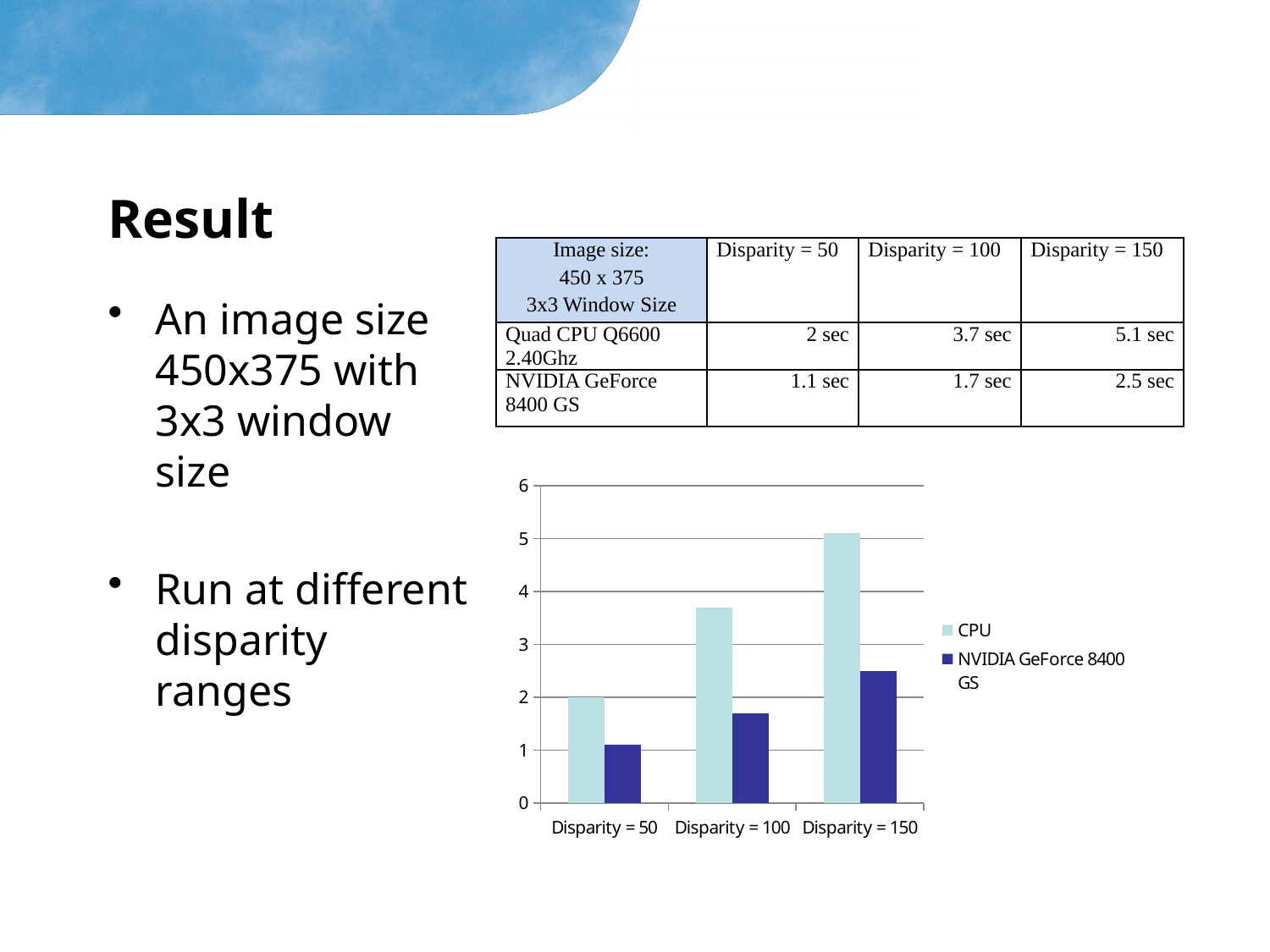
How many disparity categories are shown on the x axis of the chart? 3 What kind of chart is shown on the slide? bar chart Do the CPU values rise or fall as disparity increases along the x axis of the chart? rise According to the slide, what is the CPU time at Disparity = 50? 2 sec Which disparity category has the highest CPU value in the chart? Disparity = 150 How many series does the chart legend list? 2 In the chart, is the NVIDIA GeForce 8400 GS value at Disparity = 150 greater or less than 3? less In the chart, is the CPU value at Disparity = 150 greater or less than 5? greater Which disparity category has the lowest NVIDIA GeForce 8400 GS value in the chart? Disparity = 50 In the chart, is the CPU value at Disparity = 100 greater or less than 3? greater According to the slide, what is the NVIDIA GeForce 8400 GS time at Disparity = 150? 2.5 sec At Disparity = 100, which series has the larger value in the chart, CPU or NVIDIA GeForce 8400 GS? CPU